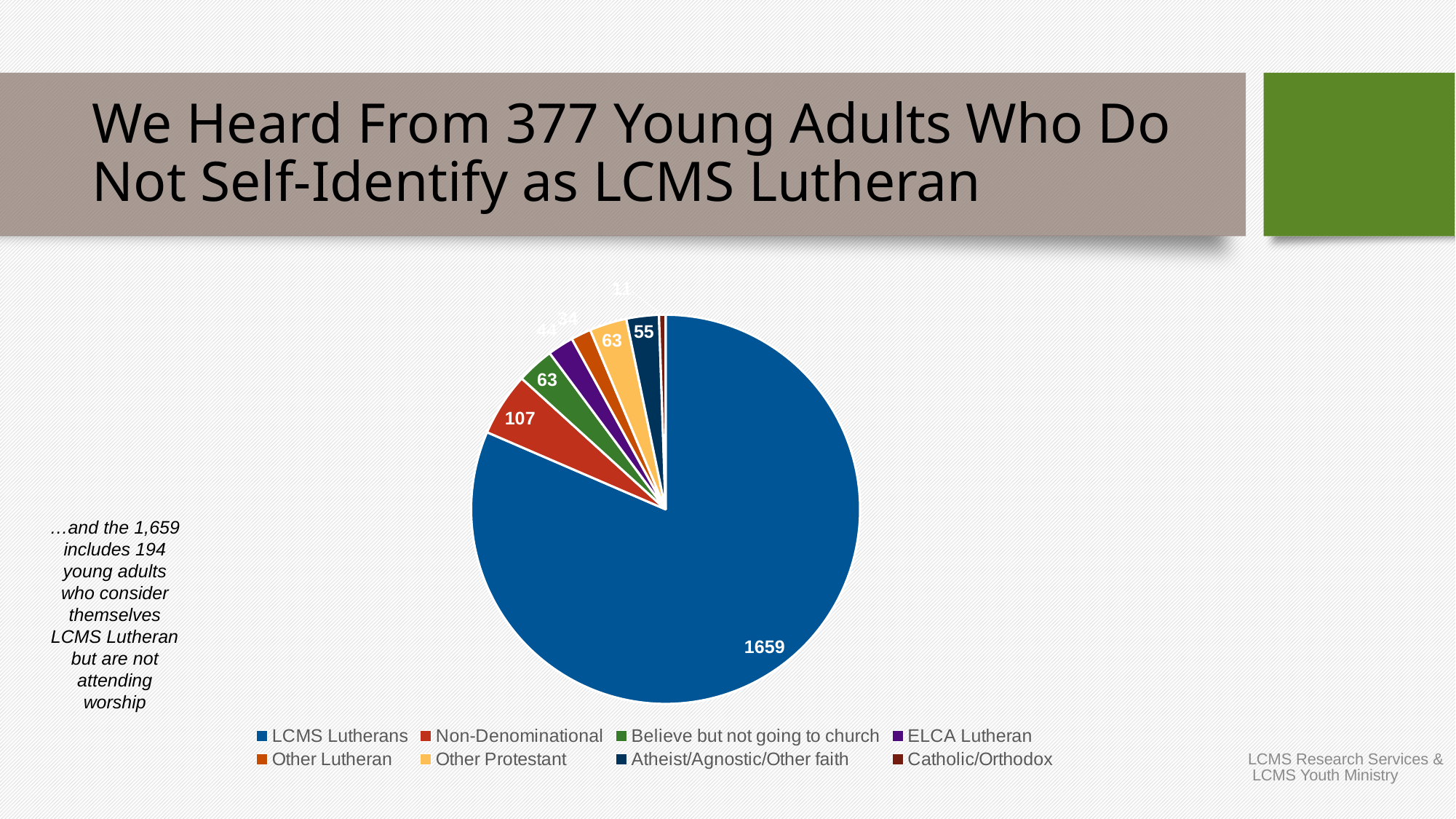
What kind of chart is shown on the slide? Pie chart What value is shown for the Non-Denominational slice? 107 Which category has the largest slice in the pie chart? LCMS Lutherans What value is shown for the Other Protestant slice? 63 What value is shown for the LCMS Lutherans slice of the pie chart? 1659 What is the difference between the Non-Denominational value and the Believe but not going to church value? 44 Which category has the smallest slice in the pie chart? Catholic/Orthodox What colour is the LCMS Lutherans slice in the pie chart? Blue How many categories does the pie chart show? 8 What value is shown for the Atheist/Agnostic/Other faith slice? 55 Which is larger, the Atheist/Agnostic/Other faith slice or the Other Lutheran slice? Atheist/Agnostic/Other faith What is the difference between the LCMS Lutherans value and the Non-Denominational value? 1552